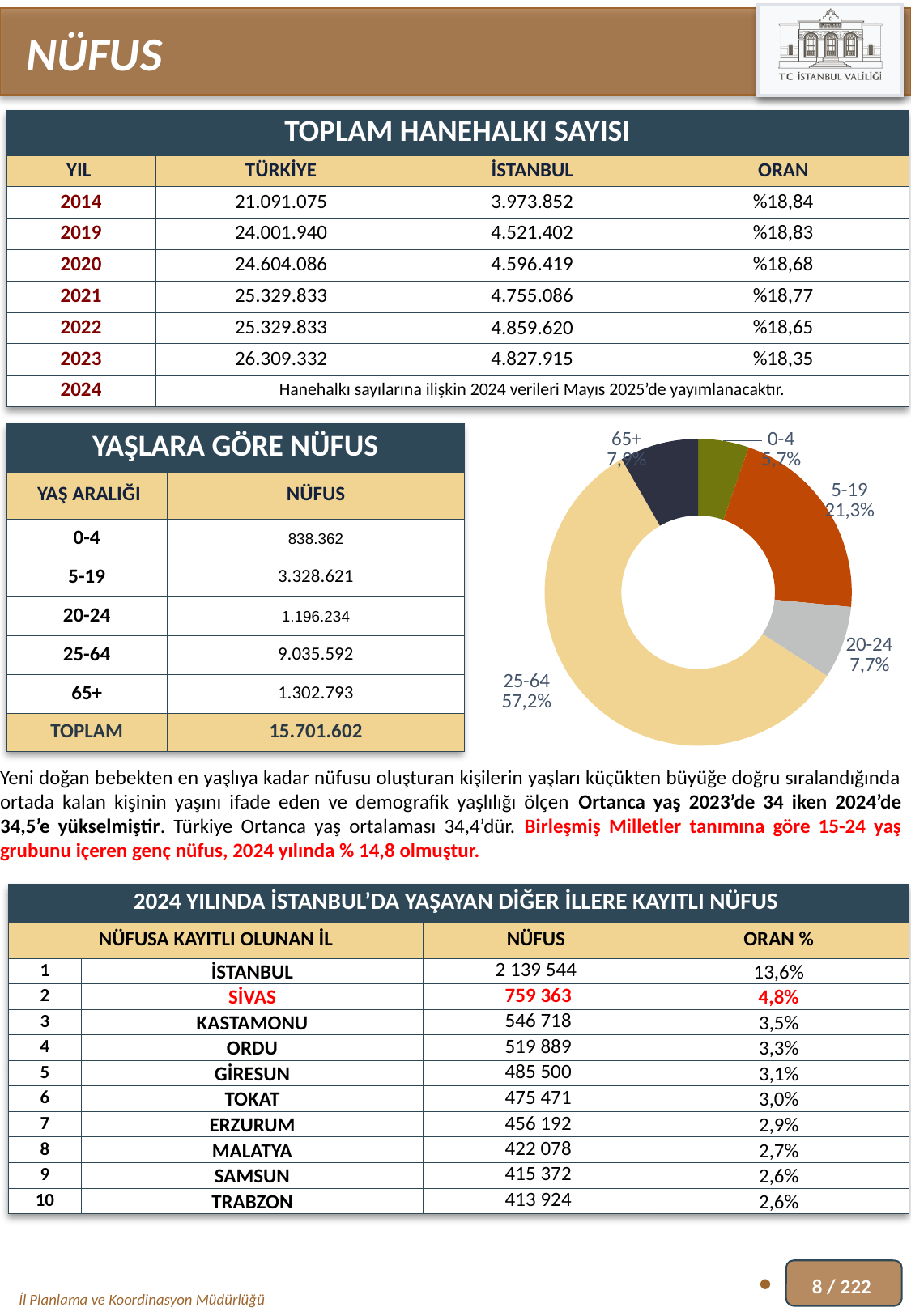
In the doughnut chart, what colour is the 5-19 slice? Orange-brown In the doughnut chart, what share of the population is in the 25-64 age group? 57,2% In the doughnut chart, how many percentage points larger is the 25-64 share than the 5-19 share? 35,9 In the doughnut chart, what percentage is shown for the 5-19 age group? 21,3% In the doughnut chart, what percentage is shown for the 0-4 age group? 5,7% How many age-group slices does the doughnut chart have? 5 Which age group has the smallest slice in the doughnut chart? 0-4 In the doughnut chart, what colour is the 25-64 slice? Beige (light tan) In the doughnut chart, what percentage is shown for the 20-24 age group? 7,7% In the doughnut chart, which slice is larger: 5-19 or 20-24? 5-19 What kind of chart is shown next to the YAŞLARA GÖRE NÜFUS table? Doughnut (pie) chart Which age group has the largest slice in the doughnut chart? 25-64